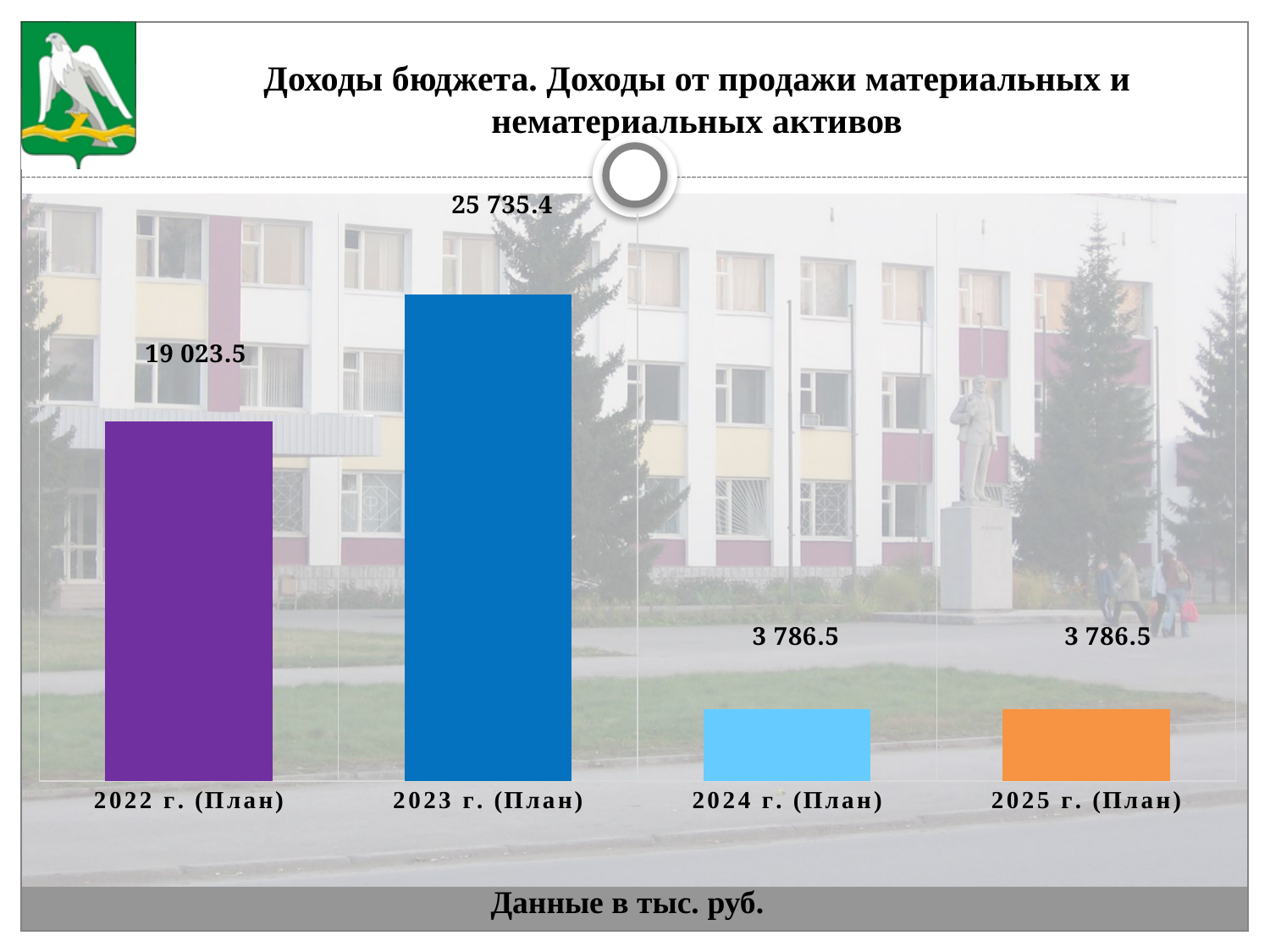
How many categories are shown in the chart? 4 What is the value for 2024 г. (План)? 3 786.5 What is the difference between the values for 2022 г. (План) and 2024 г. (План)? 15 237.0 Which is larger, the value for 2024 г. (План) or the value for 2025 г. (План)? They are equal What kind of chart is shown on the slide? Bar chart What is the value for 2023 г. (План)? 25 735.4 Which is larger, the value for 2022 г. (План) or the value for 2025 г. (План)? 2022 г. (План) What is the value for 2025 г. (План)? 3 786.5 Which year has the highest value? 2023 г. (План) What is the value for 2022 г. (План)? 19 023.5 What is the difference between the values for 2023 г. (План) and 2022 г. (План)? 6 711.9 Does the value rise or fall from 2023 г. (План) to 2024 г. (План)? Fall